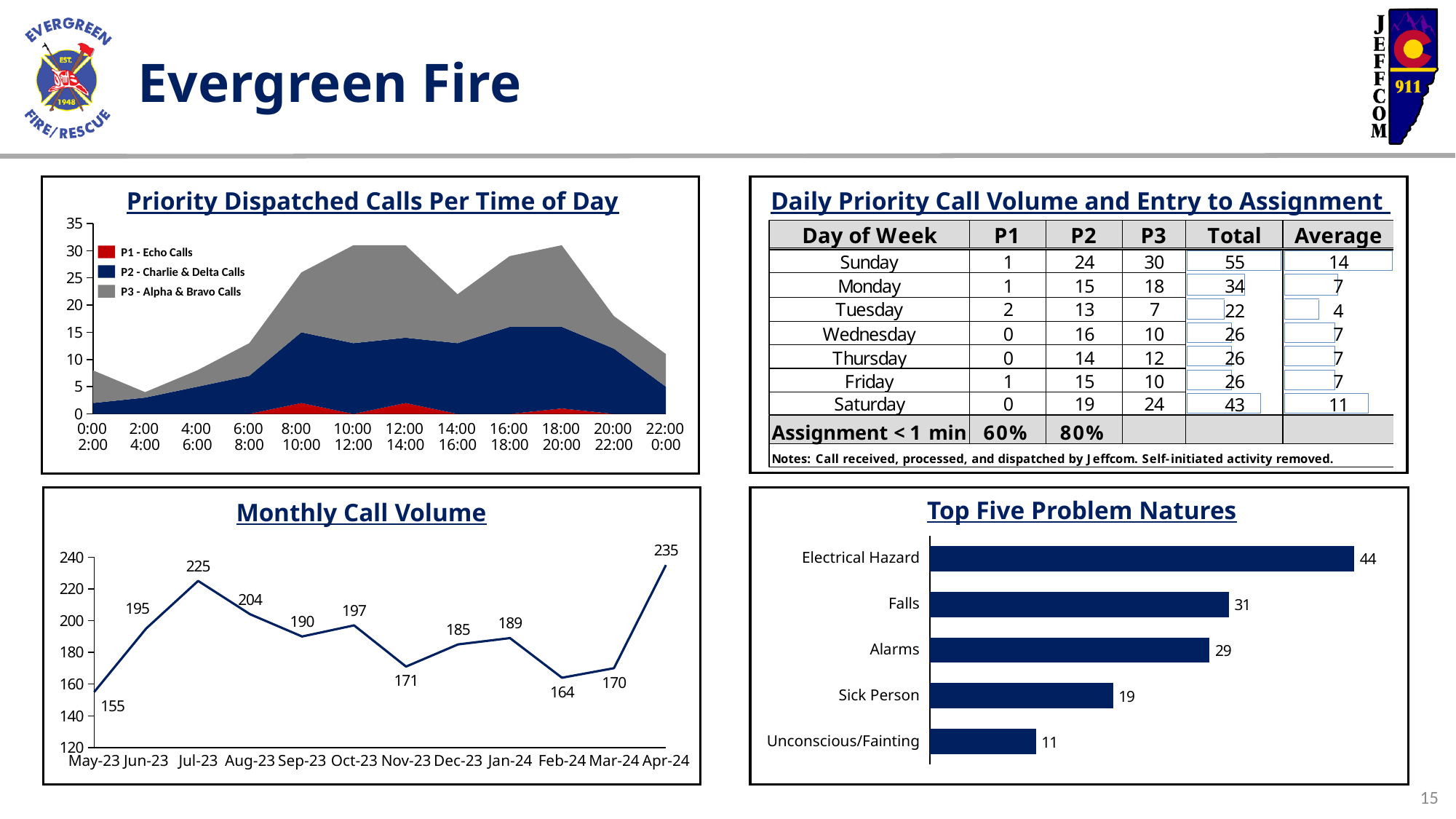
In the Monthly Call Volume chart, what is the difference between the values for Apr-24 and Mar-24? 65 What kind of chart is the Top Five Problem Natures chart? Bar chart In the Monthly Call Volume chart, which month has the lowest call volume? May-23 In the Monthly Call Volume chart, which is larger, the value for Oct-23 or the value for Sep-23? Oct-23 In the Top Five Problem Natures chart, which problem nature has the lowest value? Unconscious/Fainting How many months are plotted in the Monthly Call Volume chart? 12 In the Monthly Call Volume chart, what is the value for Jul-23? 225 In the Top Five Problem Natures chart, what is the value for Falls? 31 In the Monthly Call Volume chart, which month has the highest call volume? Apr-24 In the Top Five Problem Natures chart, what is the difference between Electrical Hazard and Alarms? 15 How many series does the legend of the Priority Dispatched Calls Per Time of Day chart list? 3 In the Priority Dispatched Calls Per Time of Day chart, is the total value for the 10:00-12:00 period greater or less than 25? greater